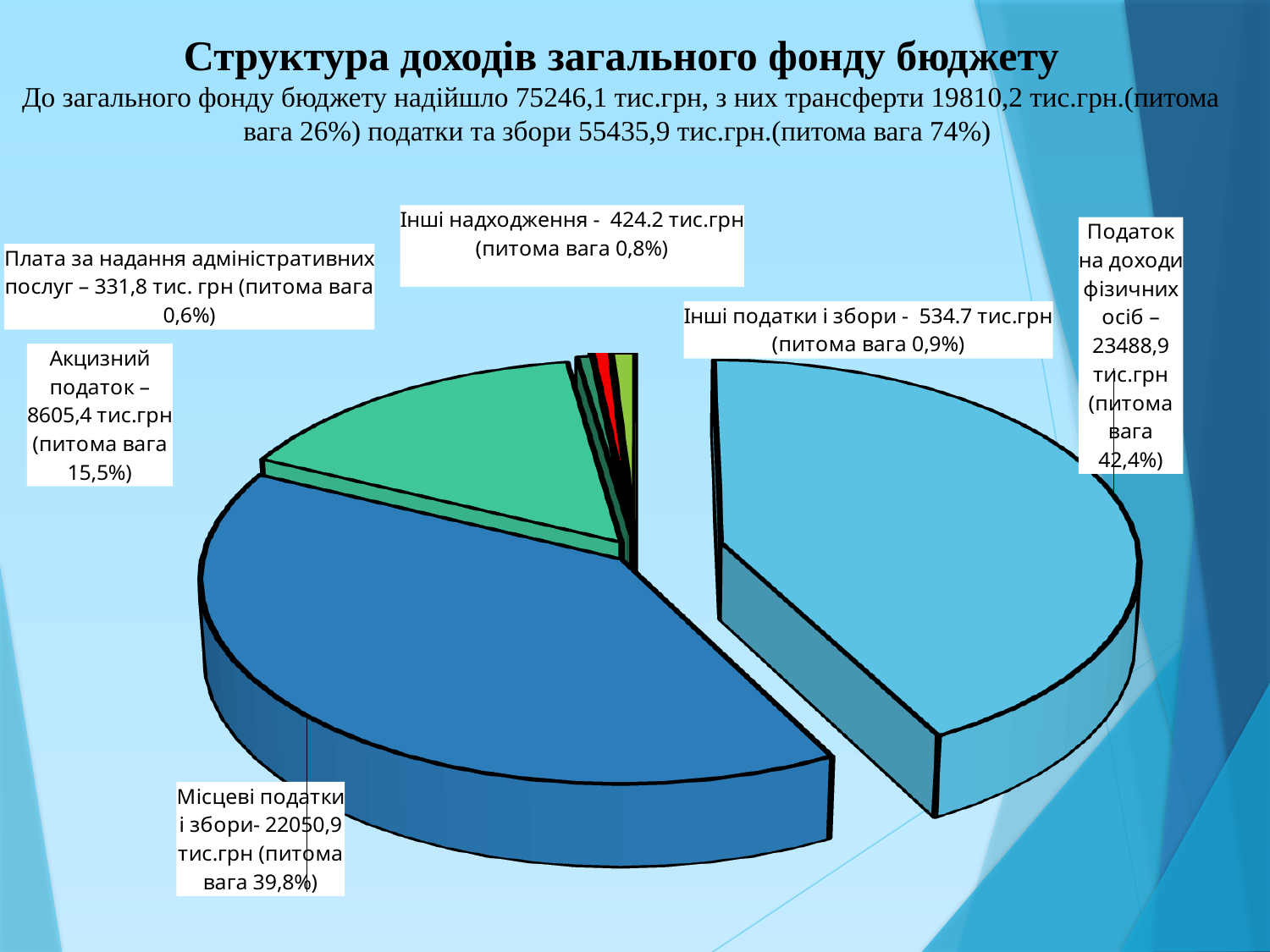
Which category has the largest slice of the pie? Податок на доходи фізичних осіб What kind of chart is shown on the slide? Pie chart What share of the pie does Акцизний податок represent (питома вага)? 15,5% Which is larger: Акцизний податок or Місцеві податки і збори? Місцеві податки і збори What is the value for Податок на доходи фізичних осіб? 23488,9 тис.грн What is the difference in питома вага between Податок на доходи фізичних осіб and Місцеві податки і збори? 2,6% How many slices does the pie chart have? 6 What is the title of the chart? Структура доходів загального фонду бюджету Which category has the smallest slice of the pie? Плата за надання адміністративних послуг What share of the pie does Інші надходження represent (питома вага)? 0,8% What is the value for Місцеві податки і збори? 22050,9 тис.грн What is the value for Акцизний податок? 8605,4 тис.грн